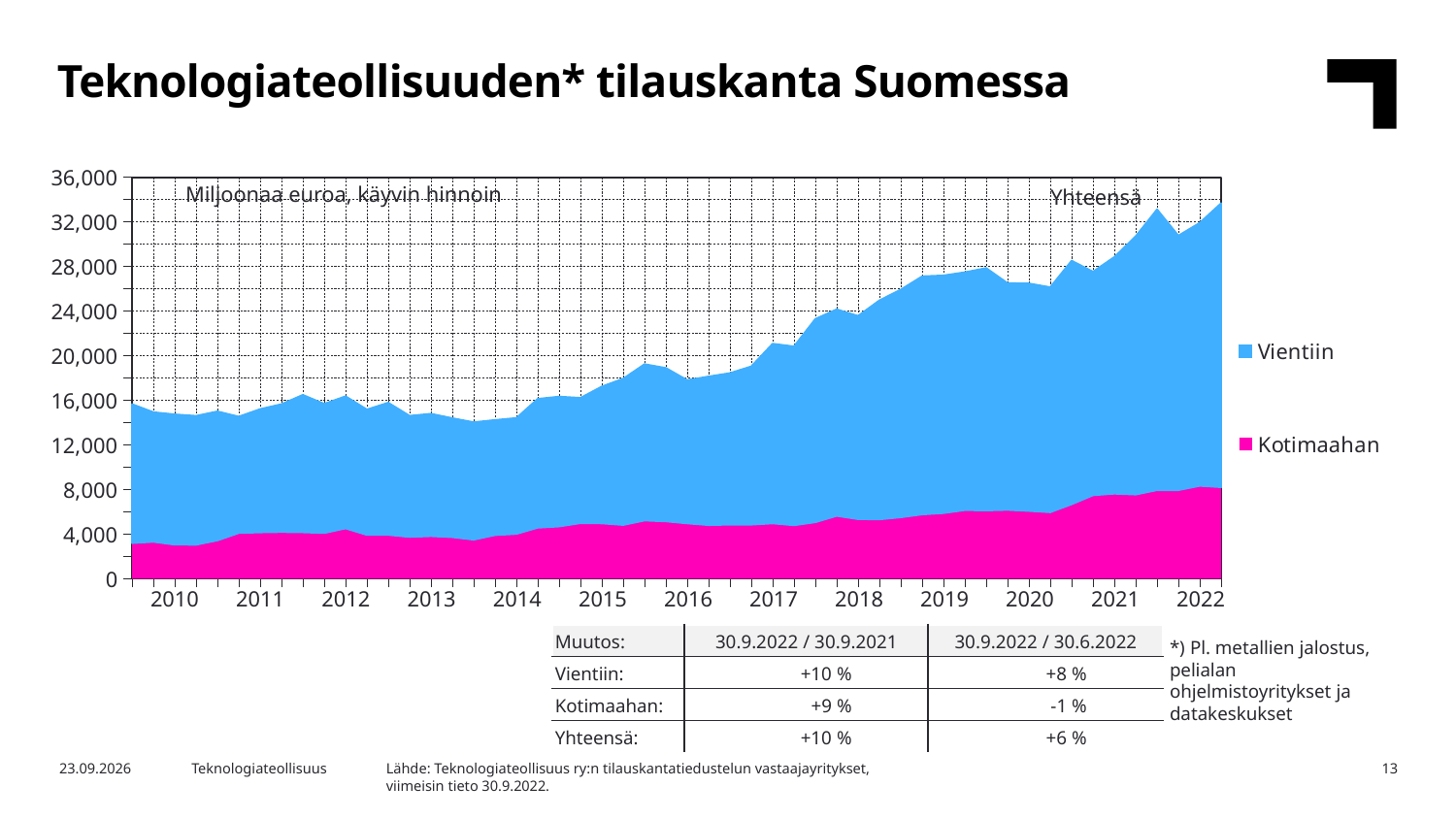
How many years are labelled on the x axis? 13 How many series does the legend list? 2 Does the total order book (Yhteensä) generally rise or fall from 2010 to 2022? Rise Is the total (Yhteensä) value at the start of 2010 greater or less than 20,000? less What unit is stated for the values in the chart? Miljoonaa euroa, käyvin hinnoin In which year does the total order book reach its highest level? 2022 Is the total (Yhteensä) value at the end of 2022 greater or less than 28,000? greater Is the Kotimaahan value at the end of 2022 greater or less than 4,000? greater Which series is larger throughout the chart, Vientiin or Kotimaahan? Vientiin What kind of chart is shown on the slide? Stacked area chart What are the two series named in the legend? Vientiin and Kotimaahan